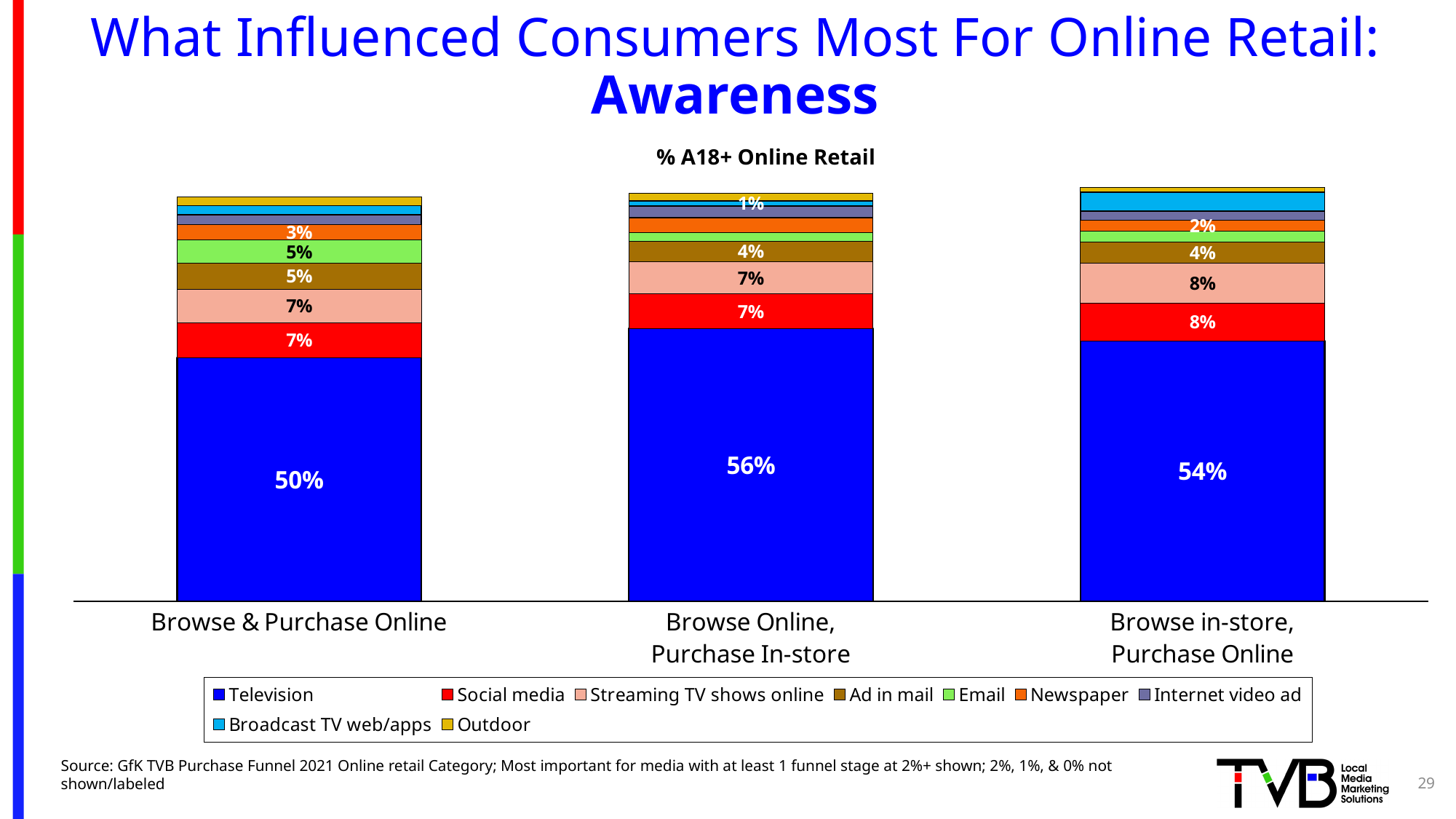
What percentage is shown for Television in the Browse in-store, Purchase Online bar? 54% How many categories (bars) are shown on the x axis? 3 How many series does the legend list? 9 What kind of chart is shown on the slide? Stacked bar chart What percentage is shown for Newspaper in the Browse & Purchase Online bar? 3% Which has a larger Social media percentage: Browse & Purchase Online or Browse in-store, Purchase Online? Browse in-store, Purchase Online What percentage is shown for Social media in the Browse in-store, Purchase Online bar? 8% What percentage is shown for Television in the Browse Online, Purchase In-store bar? 56% What is the difference in Television percentage between Browse Online, Purchase In-store and Browse & Purchase Online? 6 percentage points Which category has the highest Television percentage? Browse Online, Purchase In-store What percentage is shown for Ad in mail in the Browse Online, Purchase In-store bar? 4% What percentage is shown for Television in the Browse & Purchase Online bar? 50%